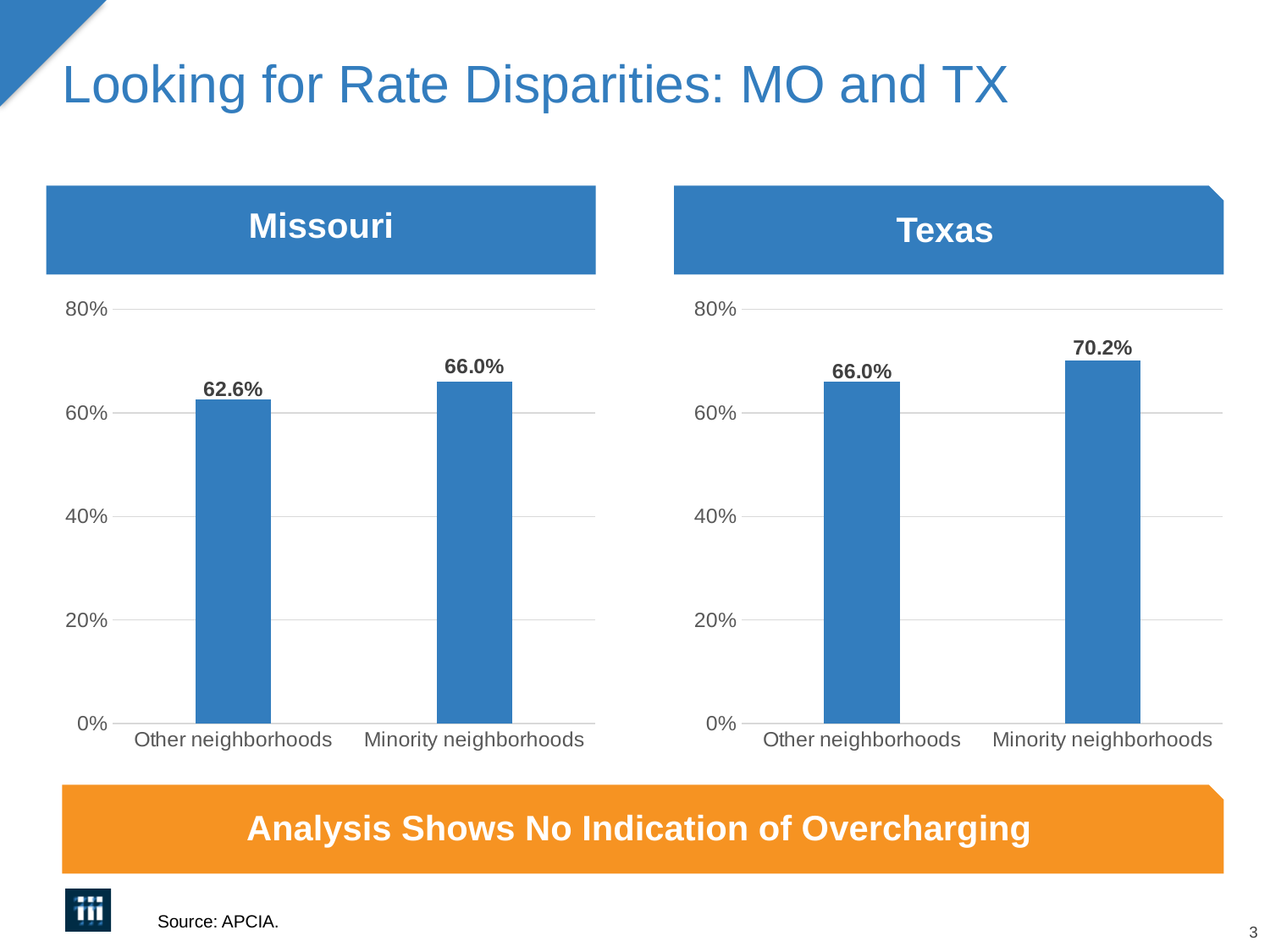
What kind of chart is the Missouri chart? bar chart In the Missouri chart, is the value for Other neighborhoods greater or less than 60%? greater In the Texas chart, which is larger: Other neighborhoods or Minority neighborhoods? Minority neighborhoods In the Texas chart, what is the value for Other neighborhoods? 66.0% In the Missouri chart, what is the value for Minority neighborhoods? 66.0% In the Texas chart, which category has the lowest value? Other neighborhoods In the Missouri chart, what is the difference between Minority neighborhoods and Other neighborhoods? 3.4% How many categories does the Texas chart show? 2 In the Missouri chart, what is the value for Other neighborhoods? 62.6% In the Texas chart, what is the difference between Minority neighborhoods and Other neighborhoods? 4.2% In the Texas chart, what is the value for Minority neighborhoods? 70.2% In the Missouri chart, which category has the highest value? Minority neighborhoods